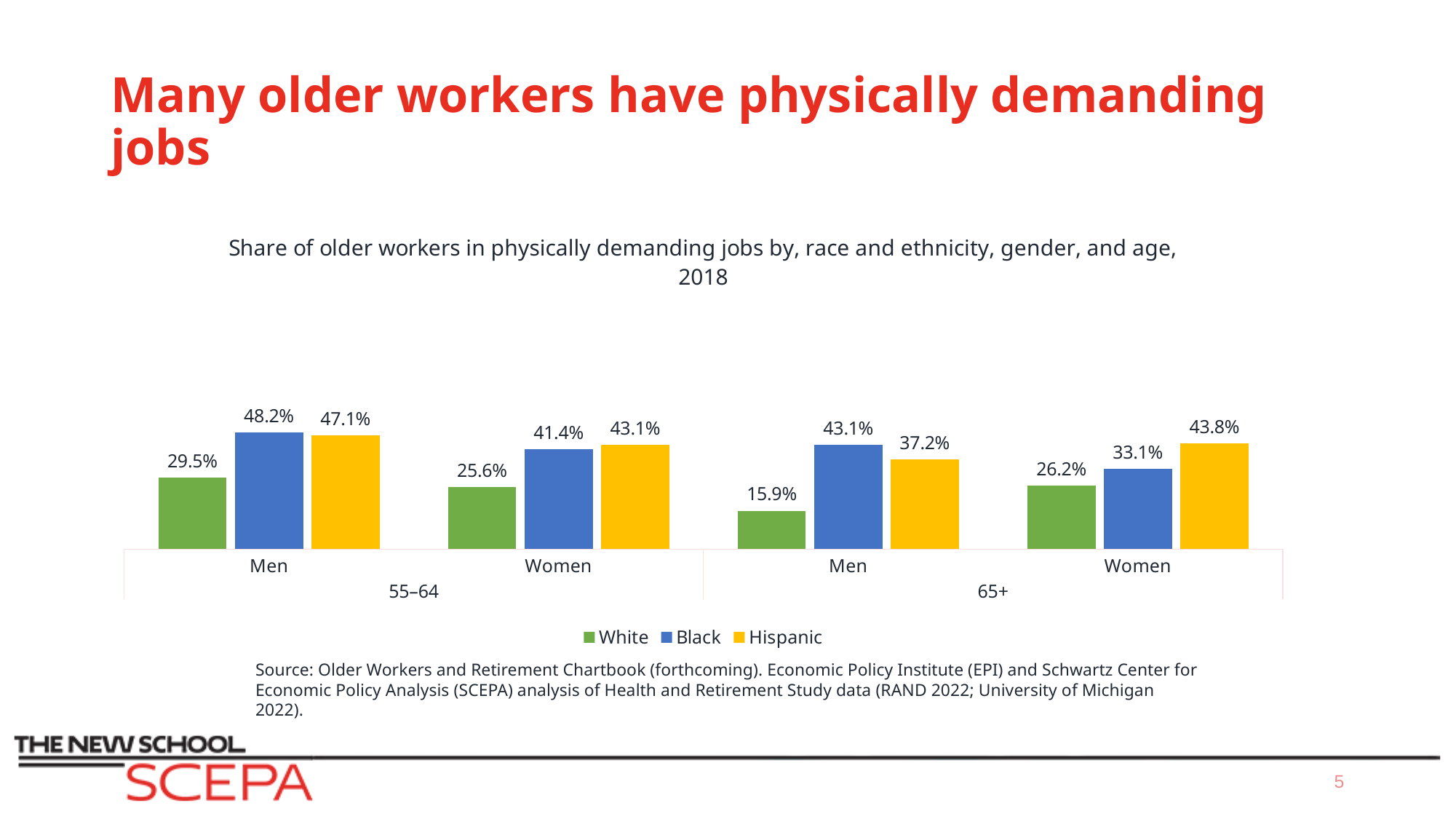
Which group has the lowest share of workers in physically demanding jobs? White men aged 65+ What kind of chart is shown on the slide? Bar chart What is the share of White men aged 55–64 in physically demanding jobs? 29.5% What is the share of Hispanic women aged 65+ in physically demanding jobs? 43.8% Which is larger: the share for Hispanic men aged 55–64 or Hispanic men aged 65+? Hispanic men aged 55–64 Which colour represents Hispanic workers in the chart? Yellow How many series does the legend list? 3 What is the share of White women aged 55–64 in physically demanding jobs? 25.6% Which group has the highest share of workers in physically demanding jobs? Black men aged 55–64 What is the difference between the shares for Hispanic women and White women aged 65+? 17.6 percentage points What is the difference between the shares for Black men and White men aged 55–64? 18.7 percentage points What is the share of Black men aged 65+ in physically demanding jobs? 43.1%